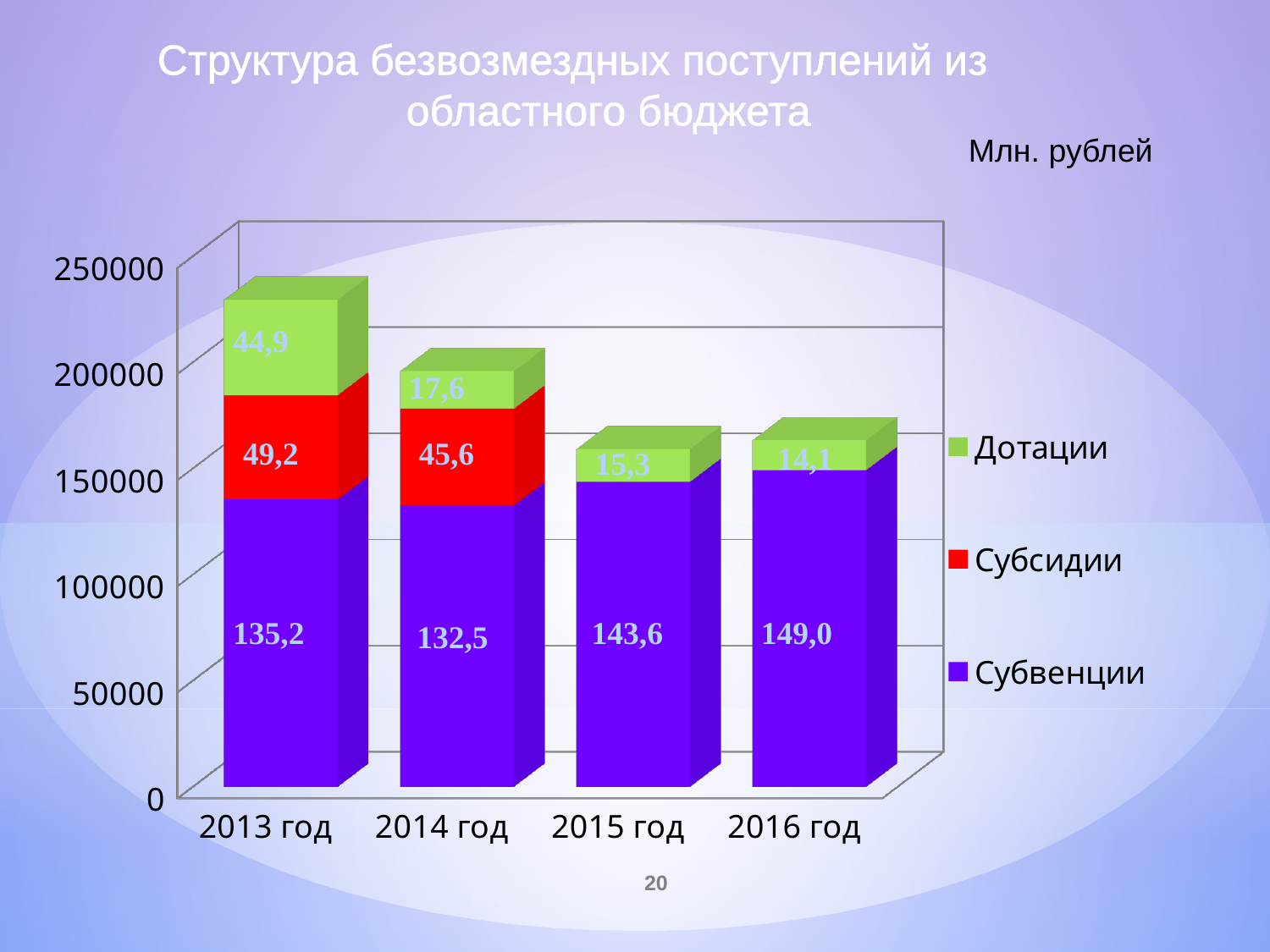
What is the value of Дотации for 2013 год? 44,9 What is the value of Субсидии for 2014 год? 45,6 Do the Дотации values rise or fall from 2013 год to 2016 год? fall What is the total of the three labelled segments in the 2013 год bar? 229,3 What is the value of Субвенции for 2015 год? 143,6 What kind of chart is shown on the slide? stacked bar chart How many series does the legend list? 3 Which is larger: Субсидии in 2013 год or Субсидии in 2014 год? 2013 год In which year is the value of Субвенции highest? 2016 год In which year is the value of Дотации lowest? 2016 год What is the difference between the Субвенции values for 2016 год and 2013 год? 13,8 How many years are shown on the x axis? 4